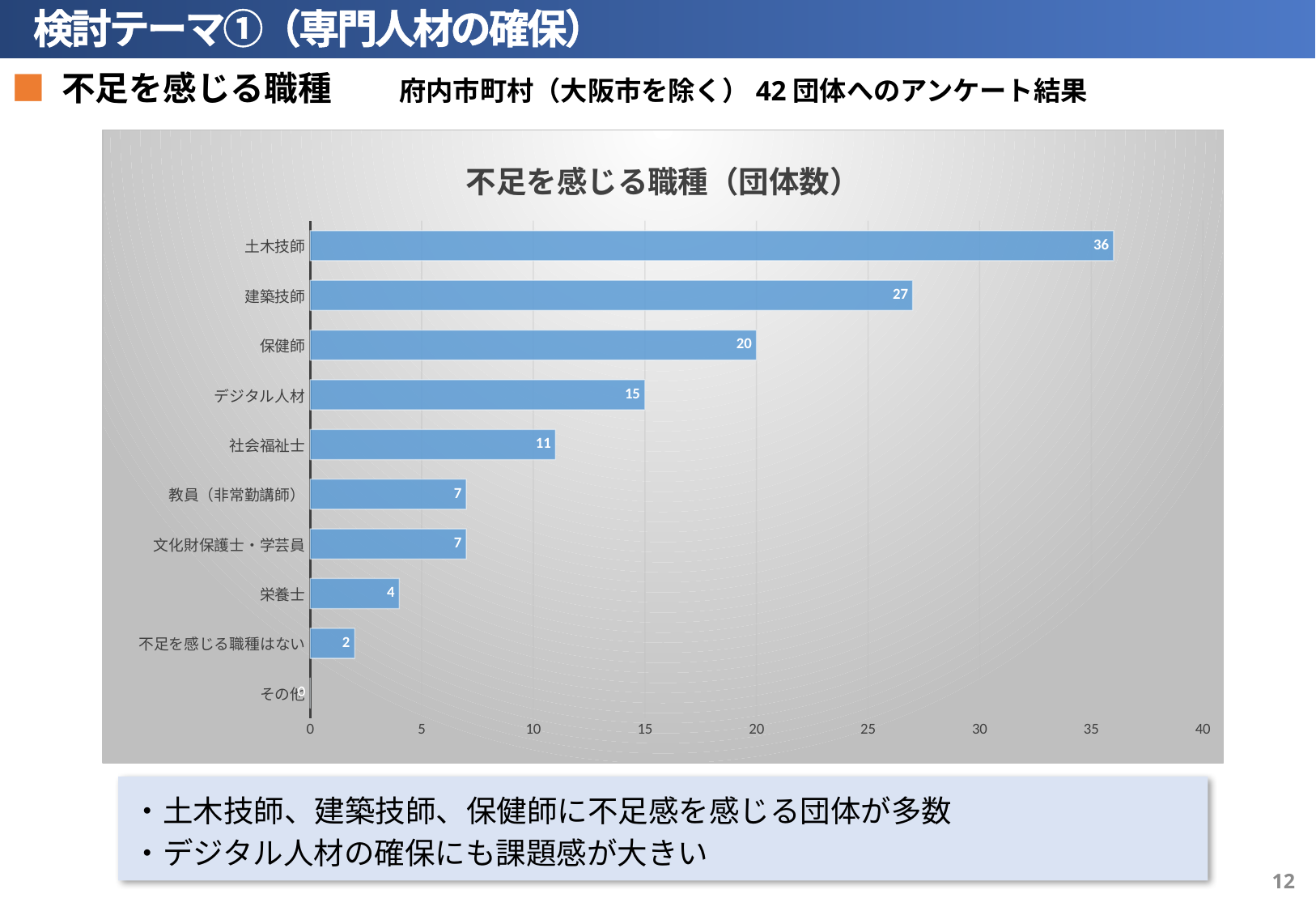
How many categories are shown in the chart? 10 What is the value for 栄養士? 4 What is the value for 保健師? 20 Which category has the lowest value? その他 Which is larger, the value for 社会福祉士 or the value for 栄養士? 社会福祉士 What is the title of the chart? 不足を感じる職種（団体数） What is the value for デジタル人材? 15 What is the value for 土木技師? 36 Which category has the highest value? 土木技師 What kind of chart is shown on the slide? bar chart Is the value for 建築技師 greater or less than 25? greater What is the difference between the values for 土木技師 and 建築技師? 9